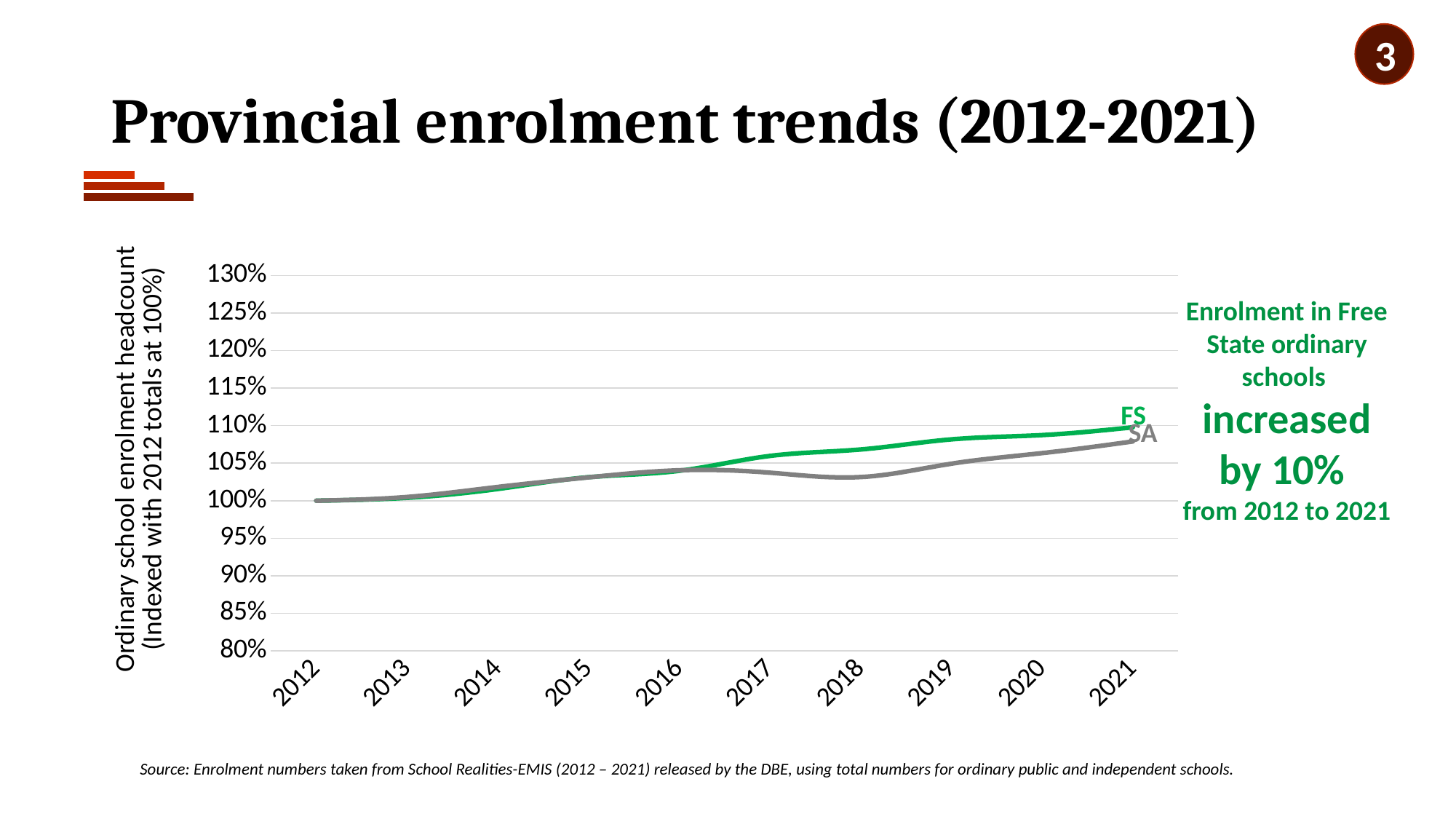
Is the value for SA in 2021 greater or less than 110%? less Is the value for SA in 2018 greater or less than 105%? less How many series are plotted on the chart? 2 What kind of chart is shown on the slide? line chart Is the value for FS in 2019 greater or less than 105%? greater Which series has the higher value in 2018, FS or SA? FS Does the FS series rise or fall from 2012 to 2021? rise What is the indexed enrolment value for FS in 2012? 100% According to the text beside the chart, by how much did enrolment in Free State ordinary schools increase from 2012 to 2021? 10% In which year does the FS series reach its highest value? 2021 How many years are shown along the x axis of the chart? 10 Which series has the higher value in 2021, FS or SA? FS